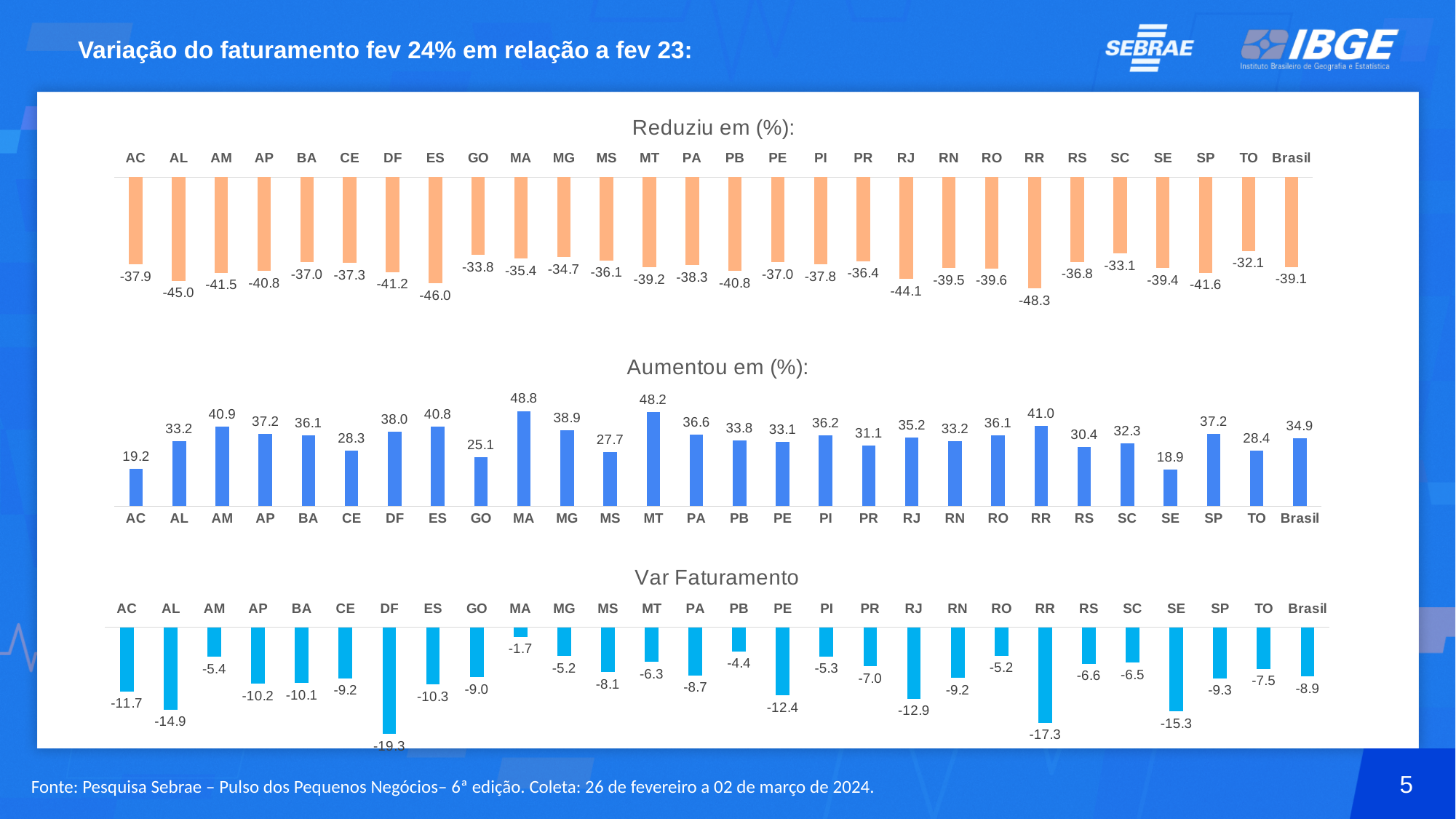
In the 'Reduziu em (%)' chart, which category has the lowest value? RR In the 'Var Faturamento' chart, which category has the lowest value? DF In the 'Aumentou em (%)' chart, what is the value for MA? 48.8 In the 'Var Faturamento' chart, which is larger, the value for MA or the value for AL? MA In the 'Aumentou em (%)' chart, which category has the highest value? MA How many categories are shown in the 'Var Faturamento' chart? 28 What kind of chart is the 'Aumentou em (%)' chart? Bar chart In the 'Reduziu em (%)' chart, what is the value for Brasil? -39.1 How many charts are shown on the slide? 3 In the 'Aumentou em (%)' chart, what is the difference between the values for MA and SE? 29.9 In the 'Var Faturamento' chart, what is the value for RR? -17.3 In the 'Aumentou em (%)' chart, which category has the lowest value? SE